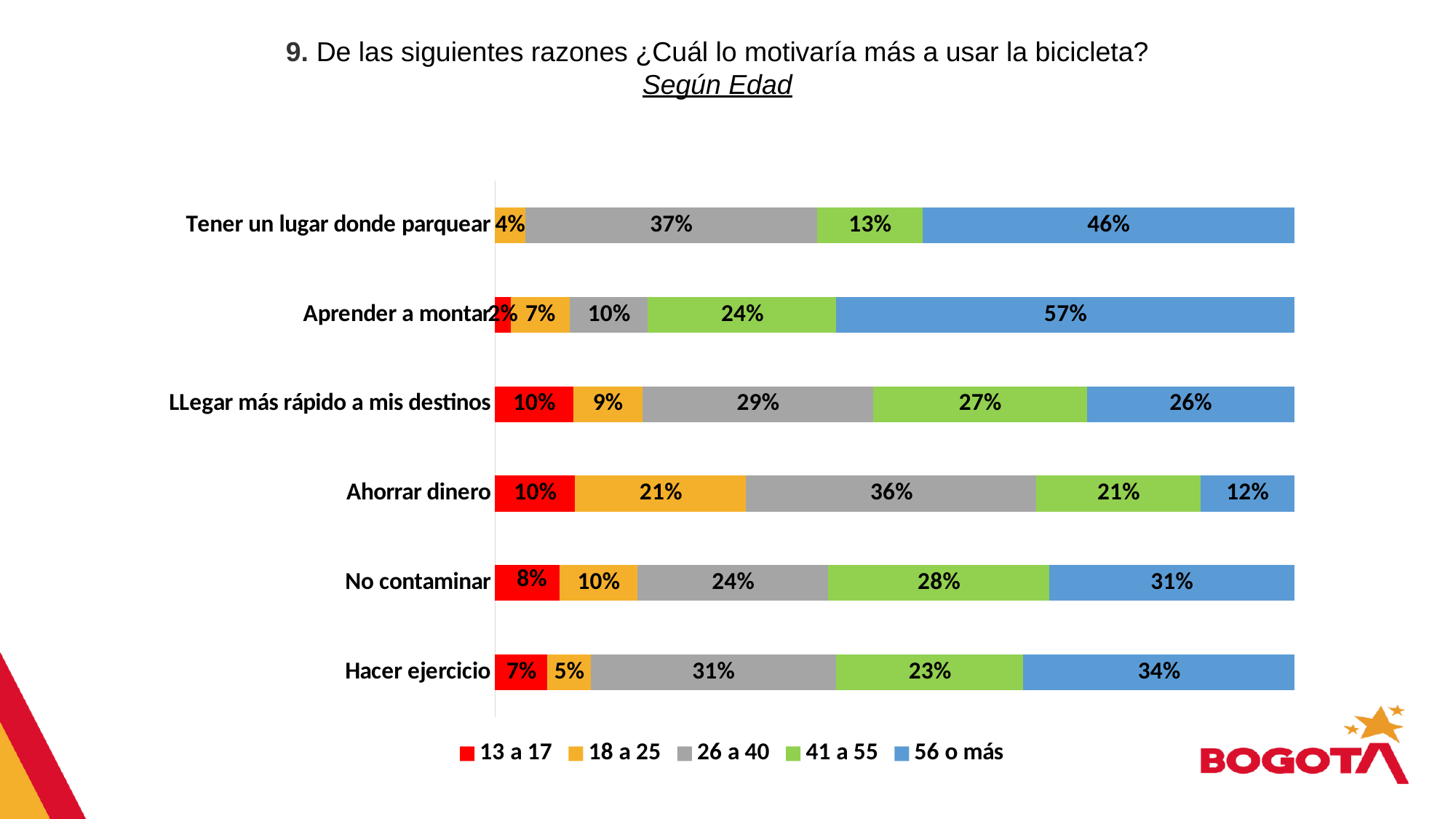
Which is larger: the '18 a 25' value for 'Ahorrar dinero' or for 'No contaminar'? Ahorrar dinero Which reason has the highest value for the '56 o más' series? Aprender a montar What is the difference between the '56 o más' values for 'Hacer ejercicio' and 'LLegar más rápido a mis destinos'? 8% What is the value for '41 a 55' in the 'No contaminar' bar? 28% Which colour represents the '13 a 17' series in the legend? Red What is the value for '56 o más' in the 'Aprender a montar' bar? 57% What is the value for '26 a 40' in the 'Ahorrar dinero' bar? 36% How many categories (reasons) are shown on the chart? 6 How many series does the legend list? 5 What is the value for '18 a 25' in the 'Tener un lugar donde parquear' bar? 4% Which reason has the lowest value for the '56 o más' series? Ahorrar dinero What kind of chart is shown on the slide? Stacked bar chart